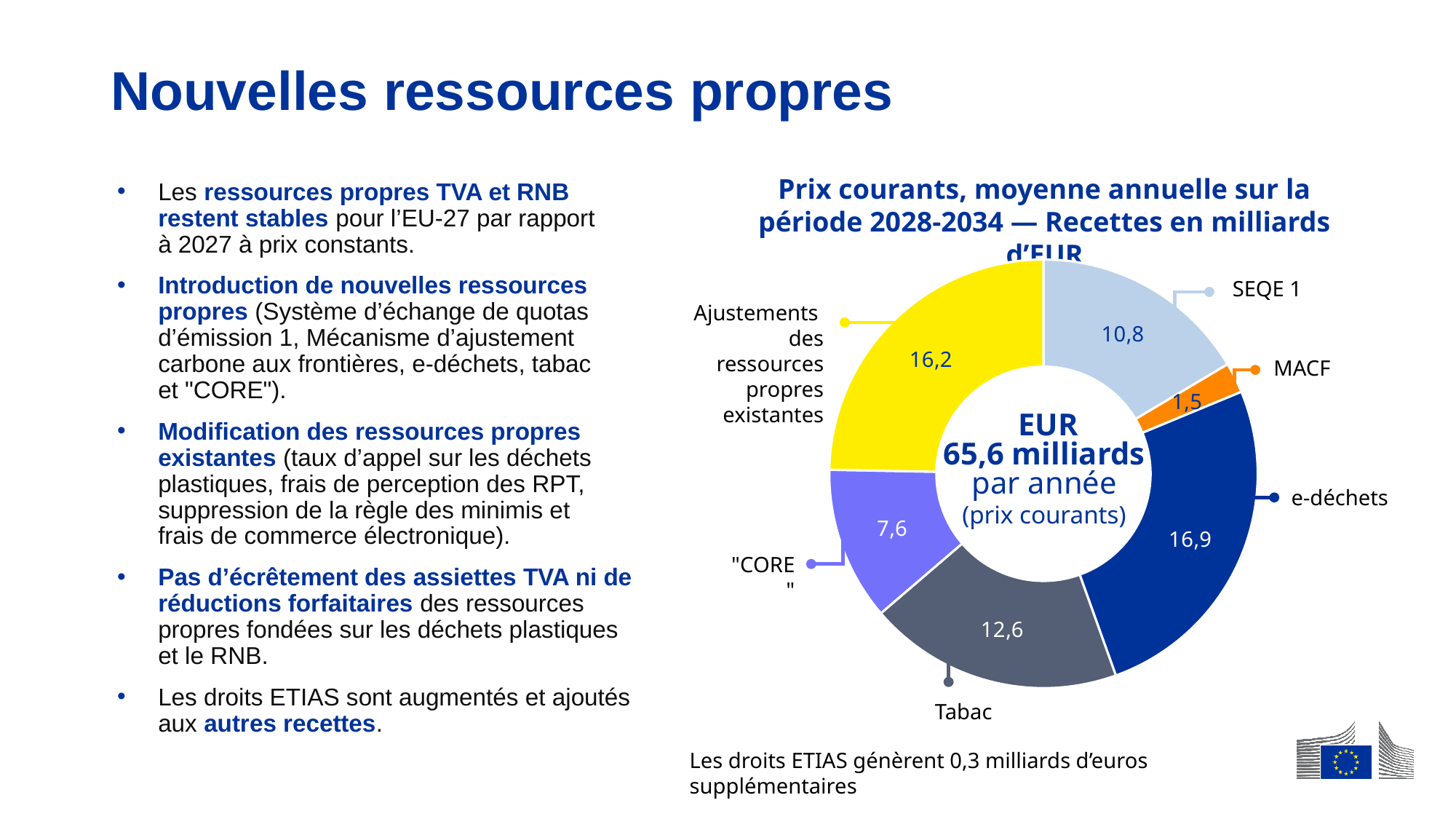
Which is larger, the value for SEQE 1 or the value for Tabac? Tabac What total amount is written in the centre of the chart? EUR 65,6 milliards par année (prix courants) What value is shown for the Tabac slice? 12,6 What value is shown for the e-déchets slice? 16,9 What value is shown for the SEQE 1 slice? 10,8 How many slices does the chart have? 6 What value is shown for the "CORE" slice? 7,6 Which category has the smallest slice in the chart? MACF What kind of chart is shown on the slide? pie chart (donut) Which category has the largest slice in the chart? e-déchets What is the difference between the Tabac value and the "CORE" value? 5,0 What value is shown for the MACF slice? 1,5